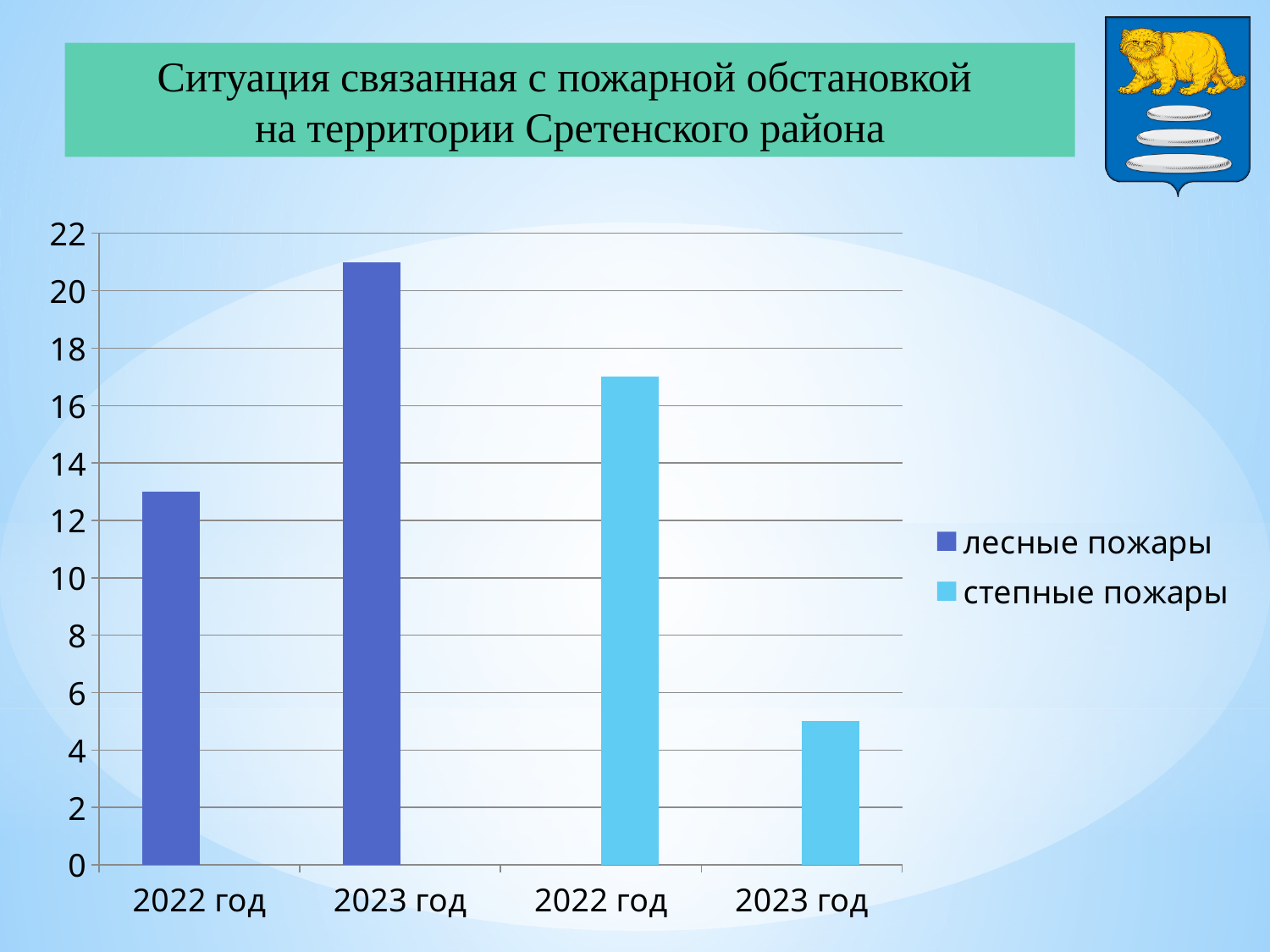
Which bar is the shortest in the chart? степные пожары, 2023 год Which bar is the tallest in the chart? лесные пожары, 2023 год Is the value for степные пожары in 2023 год greater or less than 6? less Which is larger: лесные пожары in 2023 год or степные пожары in 2022 год? лесные пожары in 2023 год Which legend entry is shown in light blue? степные пожары How many series does the legend list? 2 What kind of chart is shown on the slide? bar chart Is the value for степные пожары in 2022 год greater or less than 18? less Is the value for лесные пожары in 2022 год greater or less than 12? greater How many bars are plotted in the chart? 4 Do the values for степные пожары rise or fall from 2022 год to 2023 год? fall